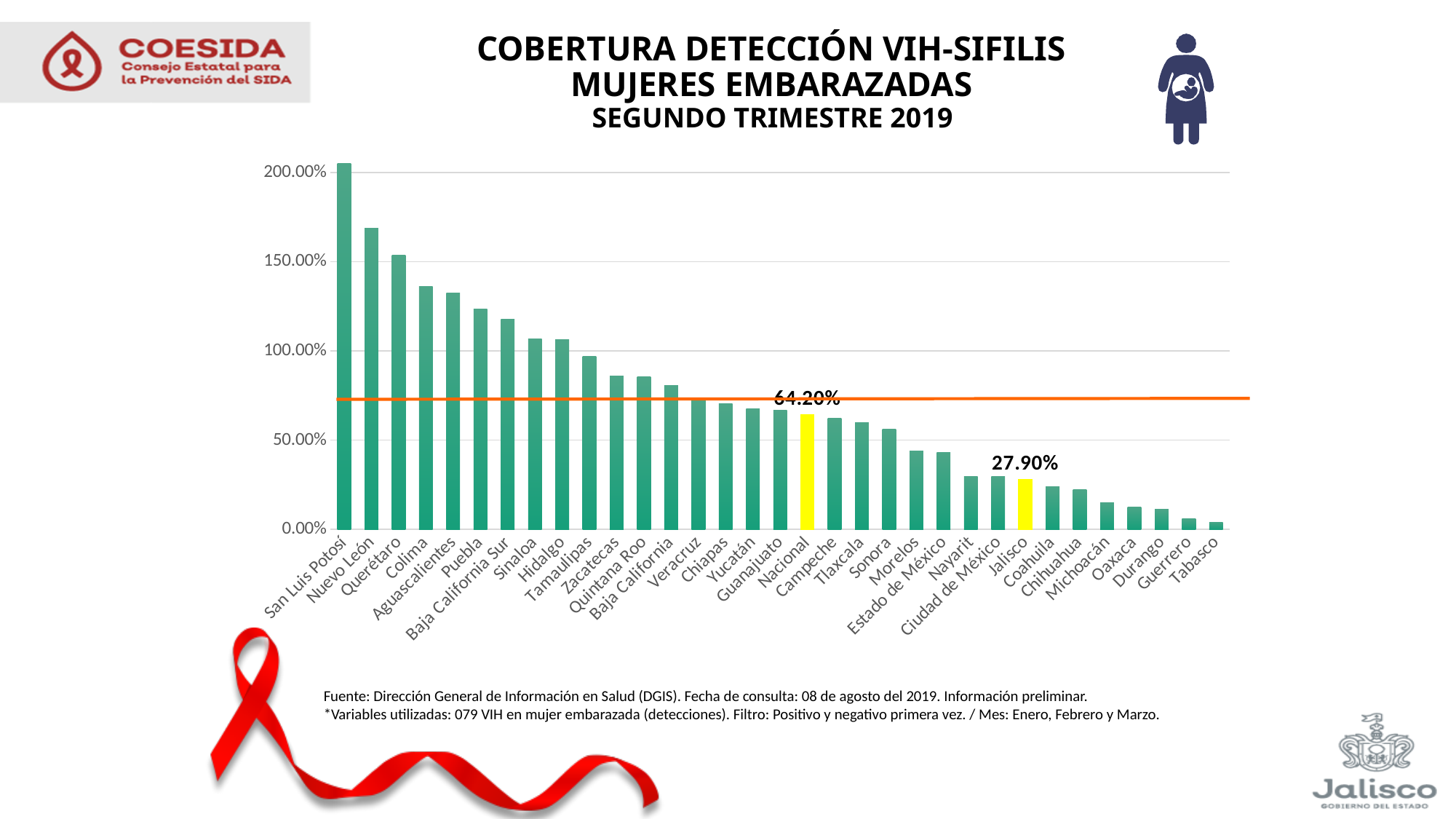
Which two bars are highlighted in yellow? Nacional and Jalisco What kind of chart is shown on the slide? Bar chart What is the difference between the Nacional value and the Jalisco value? 36.30% Which category has the lowest bar? Tabasco Which is larger, the value for Nacional or the value for Jalisco? Nacional Which is larger, the value for Nuevo León or the value for Querétaro? Nuevo León Is the value for Nuevo León greater or less than 150.00%? greater Which category has the highest bar? San Luis Potosí Is the value for Morelos greater or less than 50.00%? less Do the bar values rise or fall from left to right along the x axis? Fall What is the value shown for Nacional? 64.20% What is the value shown for Jalisco? 27.90%